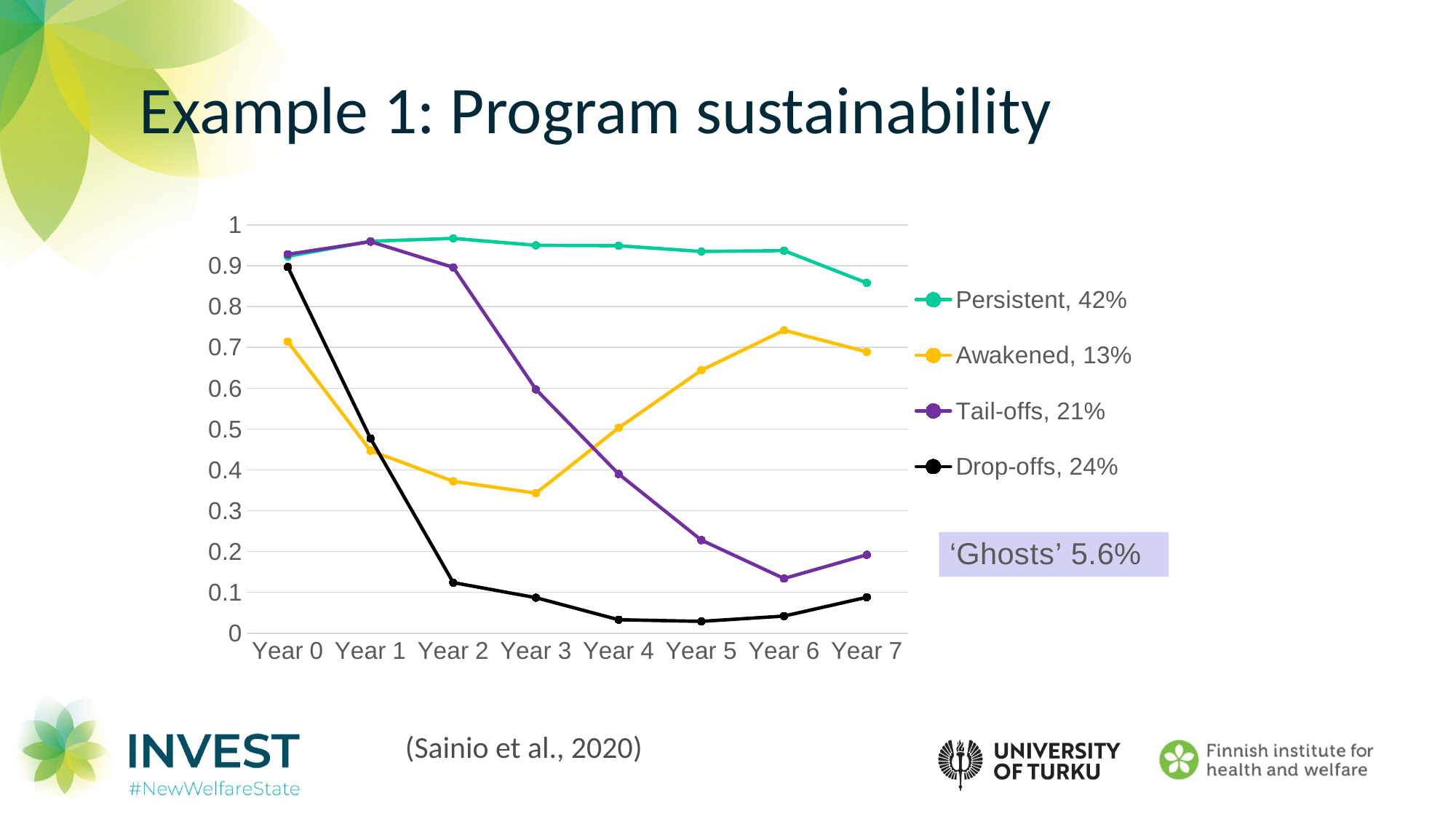
Is the value for Drop-offs at Year 4 greater or less than 0.1? less Which series has the highest value at Year 7? Persistent Which series has the lowest value at Year 2? Drop-offs What kind of chart is shown on the slide? line chart What percentage is shown next to Persistent in the legend? 42% Is the value for Persistent at Year 2 greater or less than 0.9? greater How many year points are plotted along the x axis? 8 Is the value for Tail-offs at Year 3 greater or less than 0.5? greater Do the Drop-offs values rise or fall from Year 0 to Year 4? fall At Year 5, which is larger: Awakened or Tail-offs? Awakened How many series does the legend list? 4